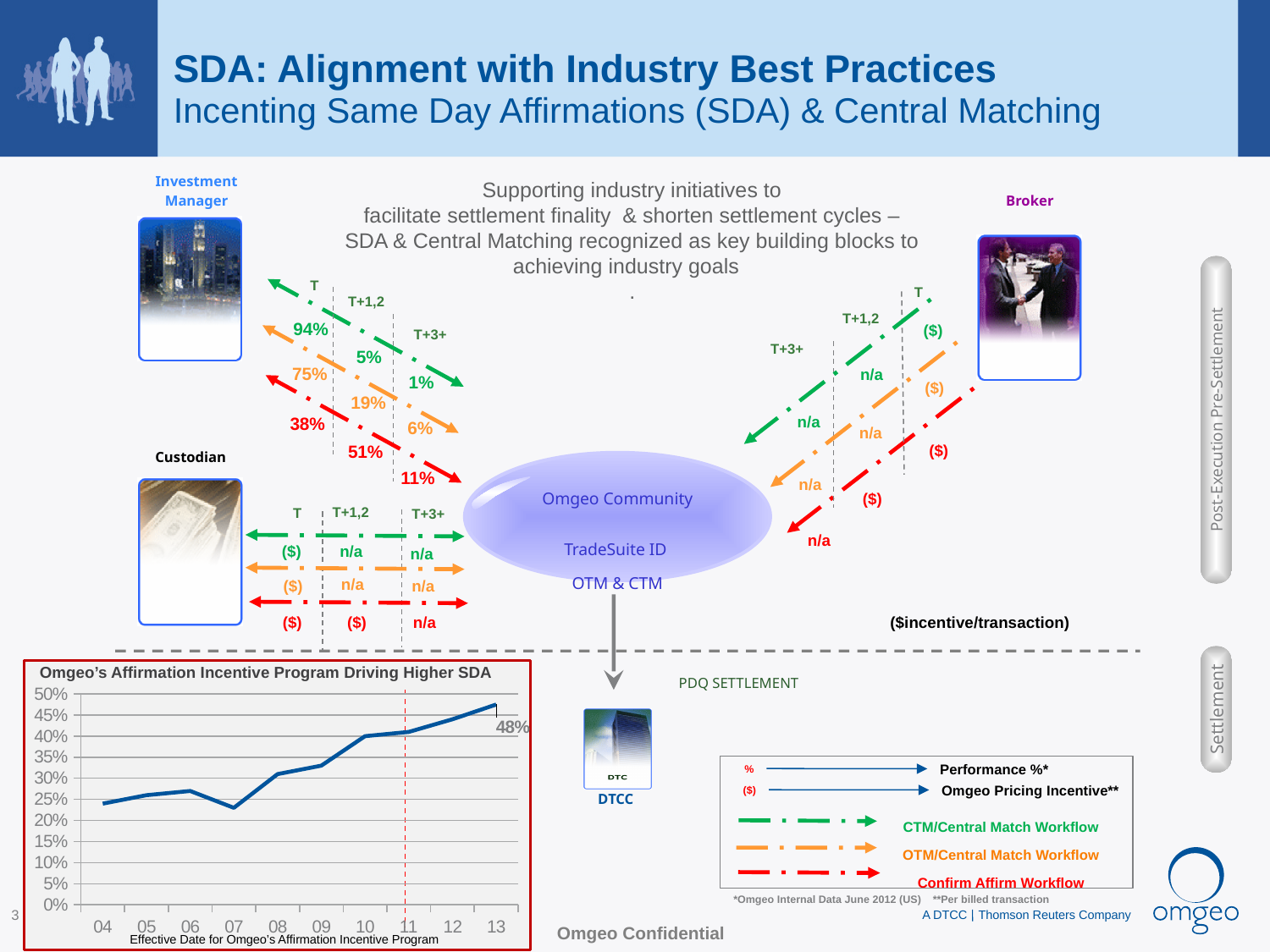
Which year has the highest value in the chart? 13 In the chart, what value is labelled for the year 13? 48% Is the value for 12 greater or less than 40%? greater Is the value for 05 greater or less than 20%? greater Is the value for 07 greater or less than 25%? less What kind of chart is shown at the bottom left of the slide? line chart What is the x-axis label of the chart? Effective Date for Omgeo's Affirmation Incentive Program How many years are plotted along the x axis of the chart? 10 What is the title of the chart at the bottom left of the slide? Omgeo's Affirmation Incentive Program Driving Higher SDA Do the values in the chart generally rise or fall from 04 to 13? rise Which is larger in the chart, the value for 10 or the value for 07? 10